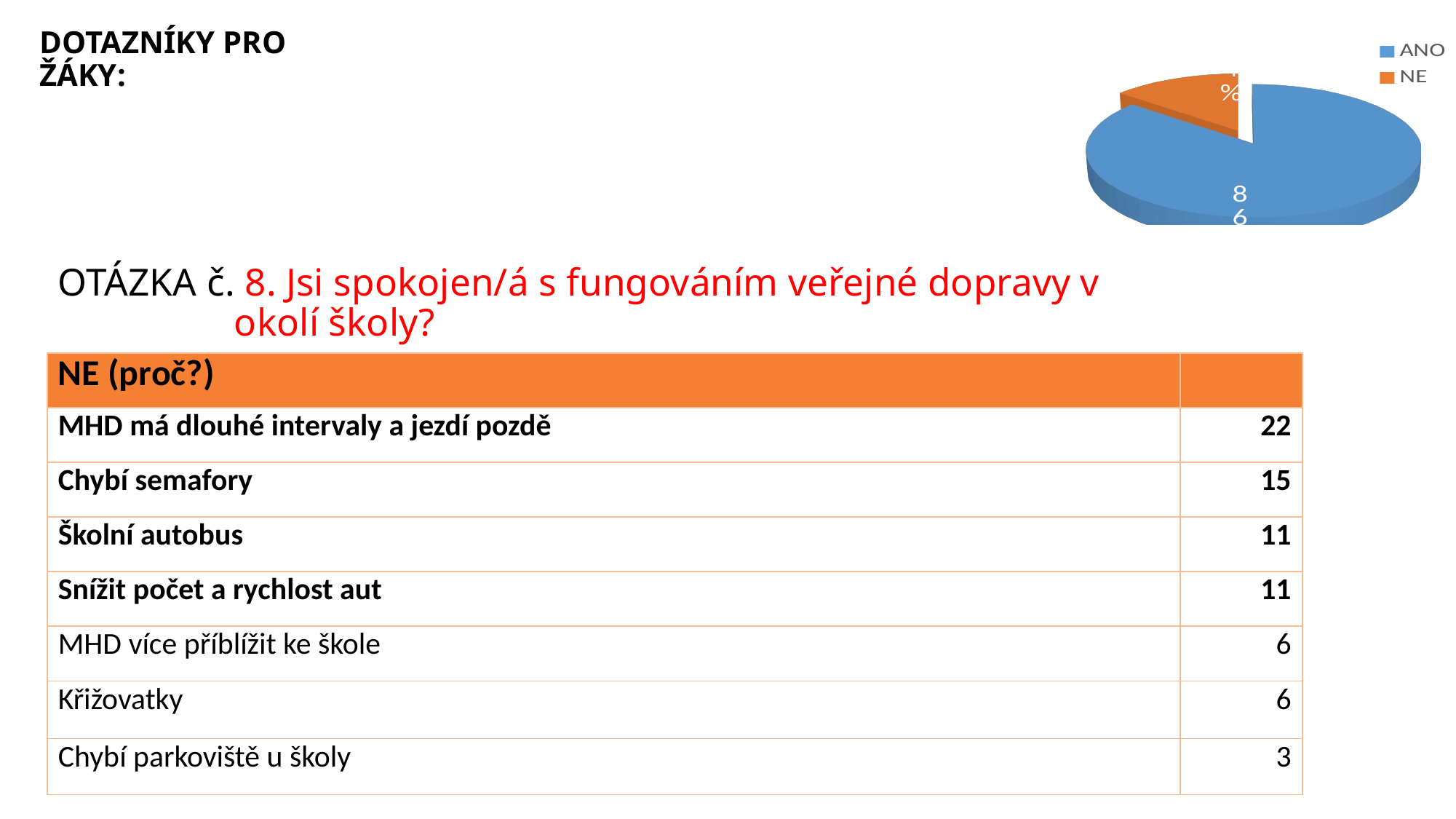
Which slice of the pie chart takes up more than half of the pie? ANO What colour is the ANO slice in the pie chart? blue Which slice of the pie chart is the smallest? NE What kind of chart is shown at the top right of the slide? pie chart How many entries does the legend of the pie chart list? 2 How many slices does the pie chart have? 2 Which slice of the pie chart is the largest? ANO What colour is the NE slice in the pie chart? orange In the pie chart, which is larger, ANO or NE? ANO